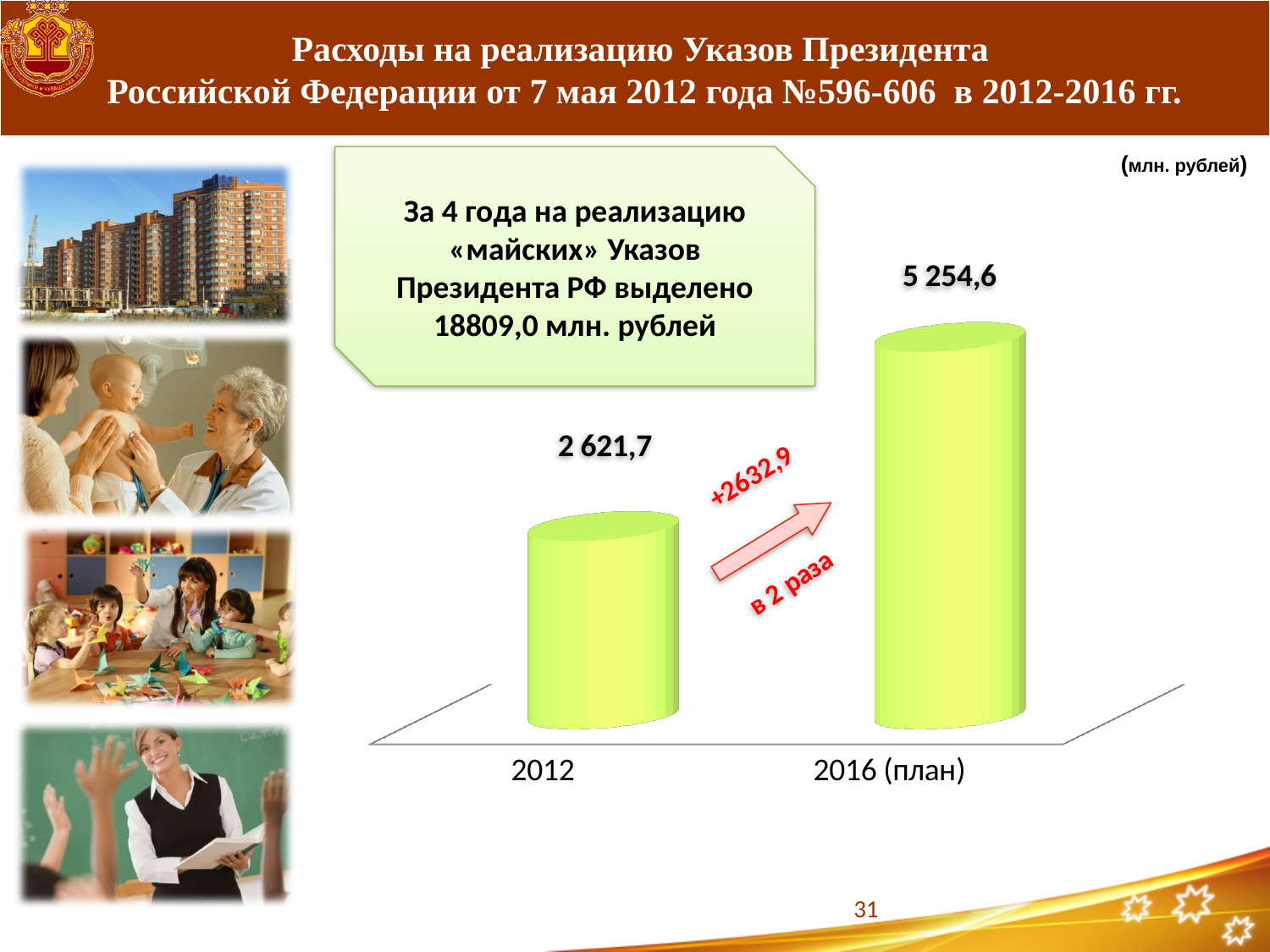
What is the value for 2012? 2 621,7 What is the value for 2016 (план)? 5 254,6 What total amount over 4 years is stated in the callout box on the slide? 18809,0 млн. рублей Which category has the lowest value? 2012 In what units are the chart values given? млн. рублей Which category has the highest value? 2016 (план) How many categories are shown in the chart? 2 Which is larger, the value for 2012 or the value for 2016 (план)? 2016 (план) What is the difference between the values for 2016 (план) and 2012? 2 632,9 Do the values rise or fall from 2012 to 2016 (план)? rise What kind of chart is shown on the slide? bar chart